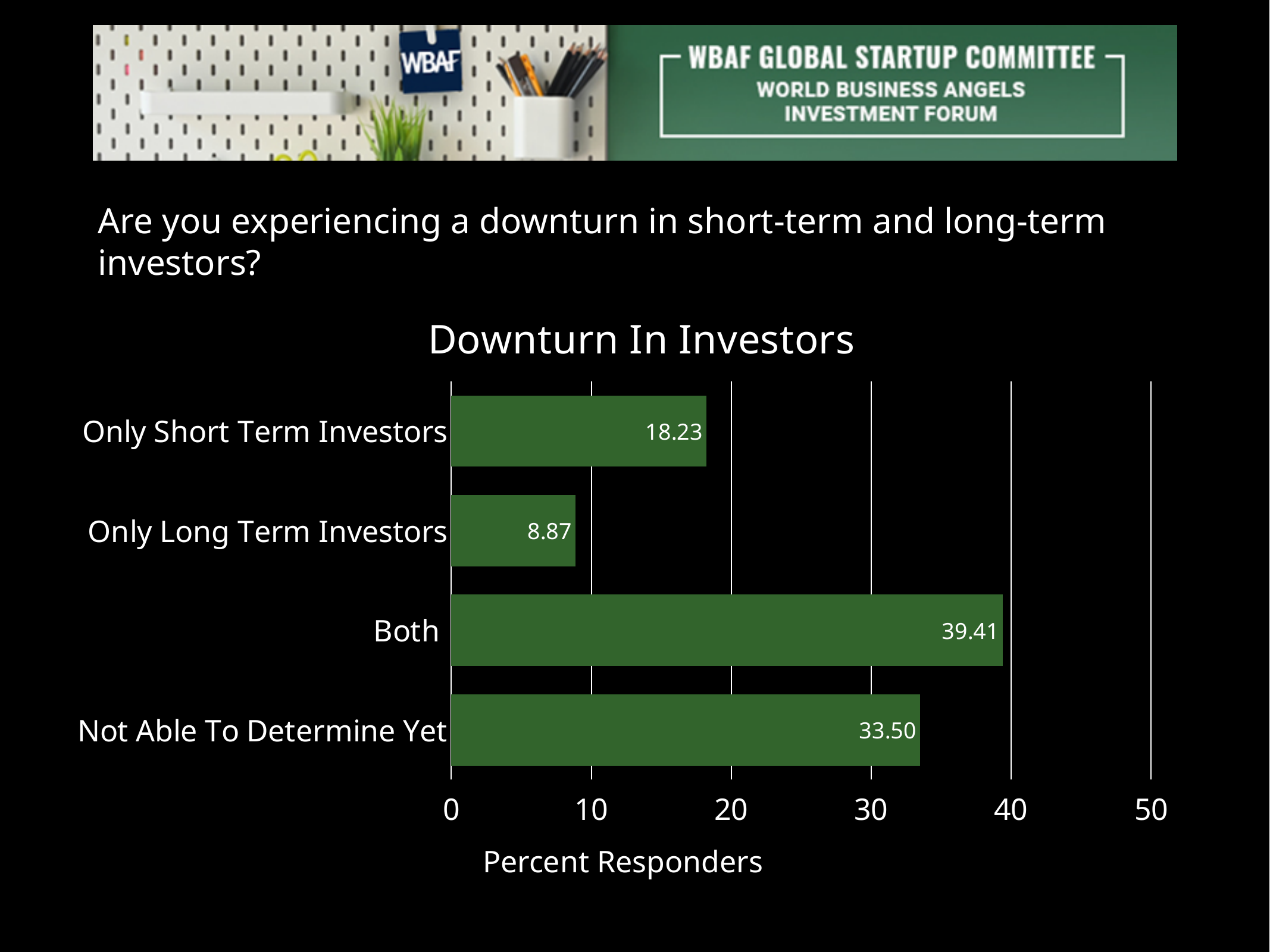
How many categories are shown in the chart? 4 Which is larger, the value for Only Short Term Investors or the value for Not Able To Determine Yet? Not Able To Determine Yet What is the value for Both? 39.41 What is the difference between the values for Only Short Term Investors and Only Long Term Investors? 9.36 What is the title of the chart? Downturn In Investors Which category has the highest value? Both What is the value for Only Long Term Investors? 8.87 Which category has the lowest value? Only Long Term Investors What is the difference between the values for Both and Not Able To Determine Yet? 5.91 What is the value for Not Able To Determine Yet? 33.50 What is the value for Only Short Term Investors? 18.23 What kind of chart is shown on the slide? bar chart